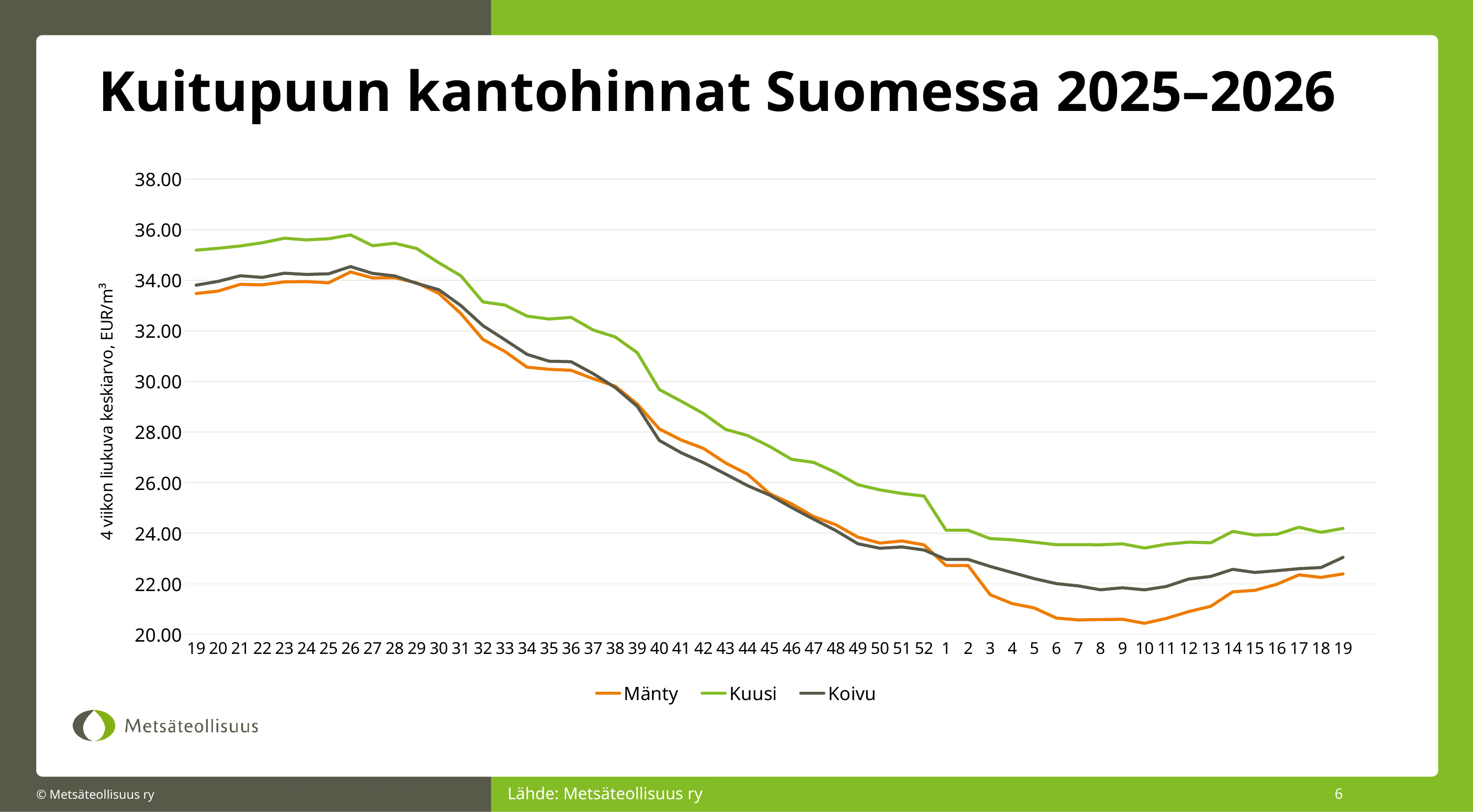
Does the Mänty line rise or fall from week 26 to week 8? fall What kind of chart is shown on the slide? line chart Is the value for Koivu at week 40 greater or less than 30.00? less Is the value for Kuusi at week 52 greater or less than 24.00? greater Which series are listed in the legend? Mänty, Kuusi, Koivu What is the title of the chart on the slide? Kuitupuun kantohinnat Suomessa 2025–2026 At week 10, which series has the higher value, Kuusi or Mänty? Kuusi Which series has the lowest value at week 8? Mänty How many series does the legend list? 3 How many weeks (points) are shown along the x axis? 53 Is the value for Kuusi at week 26 greater or less than 34.00? greater